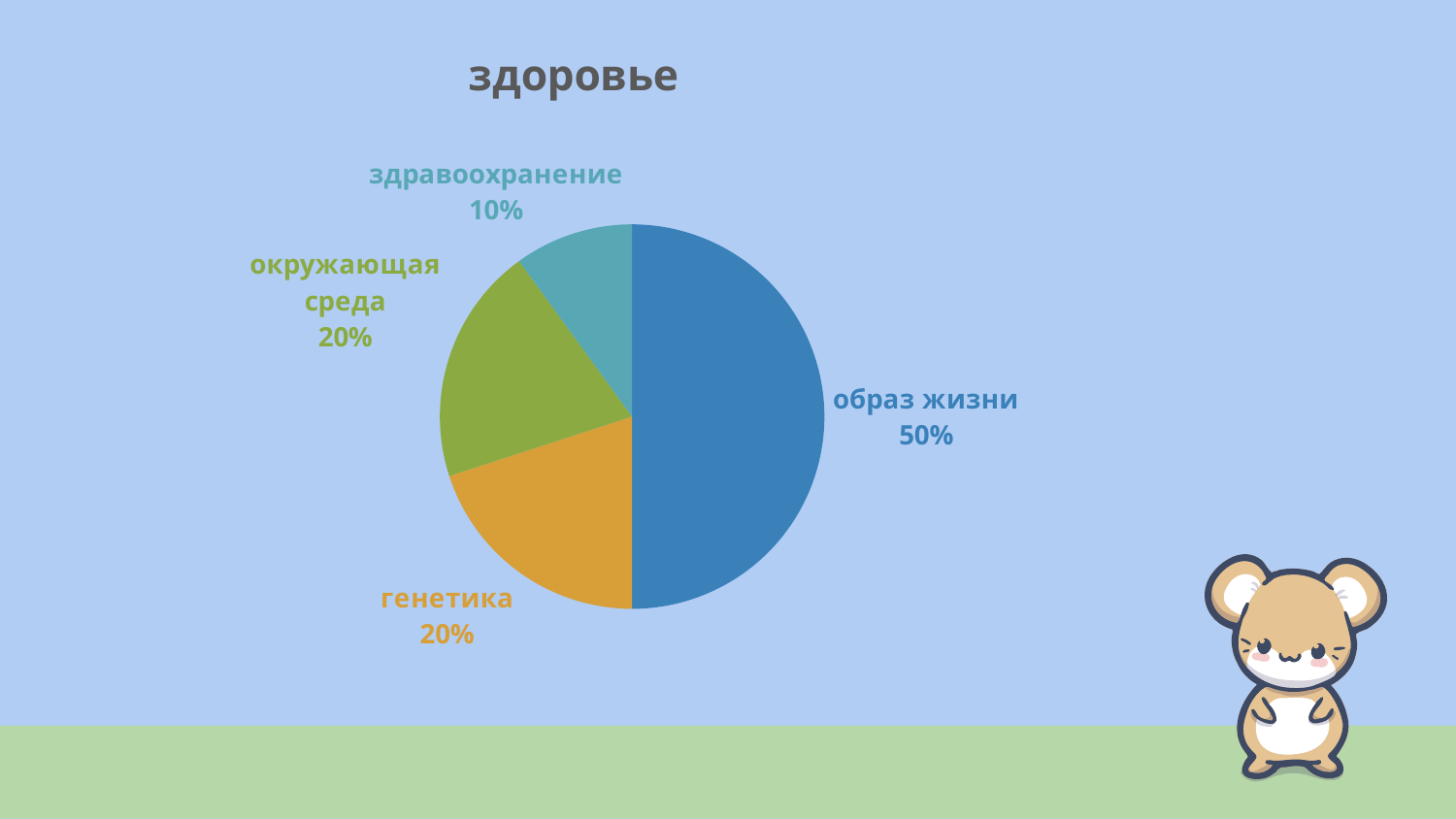
What is the difference between the shares of образ жизни and здравоохранение? 40% What kind of chart is shown on the slide? pie chart What is the title of the chart? здоровье What colour is the slice for образ жизни? blue What is the value shown for здравоохранение? 10% Which is larger, the share for генетика or the share for здравоохранение? генетика What is the value shown for окружающая среда? 20% What is the value shown for генетика? 20% Which category has the largest slice of the pie? образ жизни Which category has the smallest slice of the pie? здравоохранение What share of the pie does образ жизни take? 50% How many slices does the pie chart have? 4